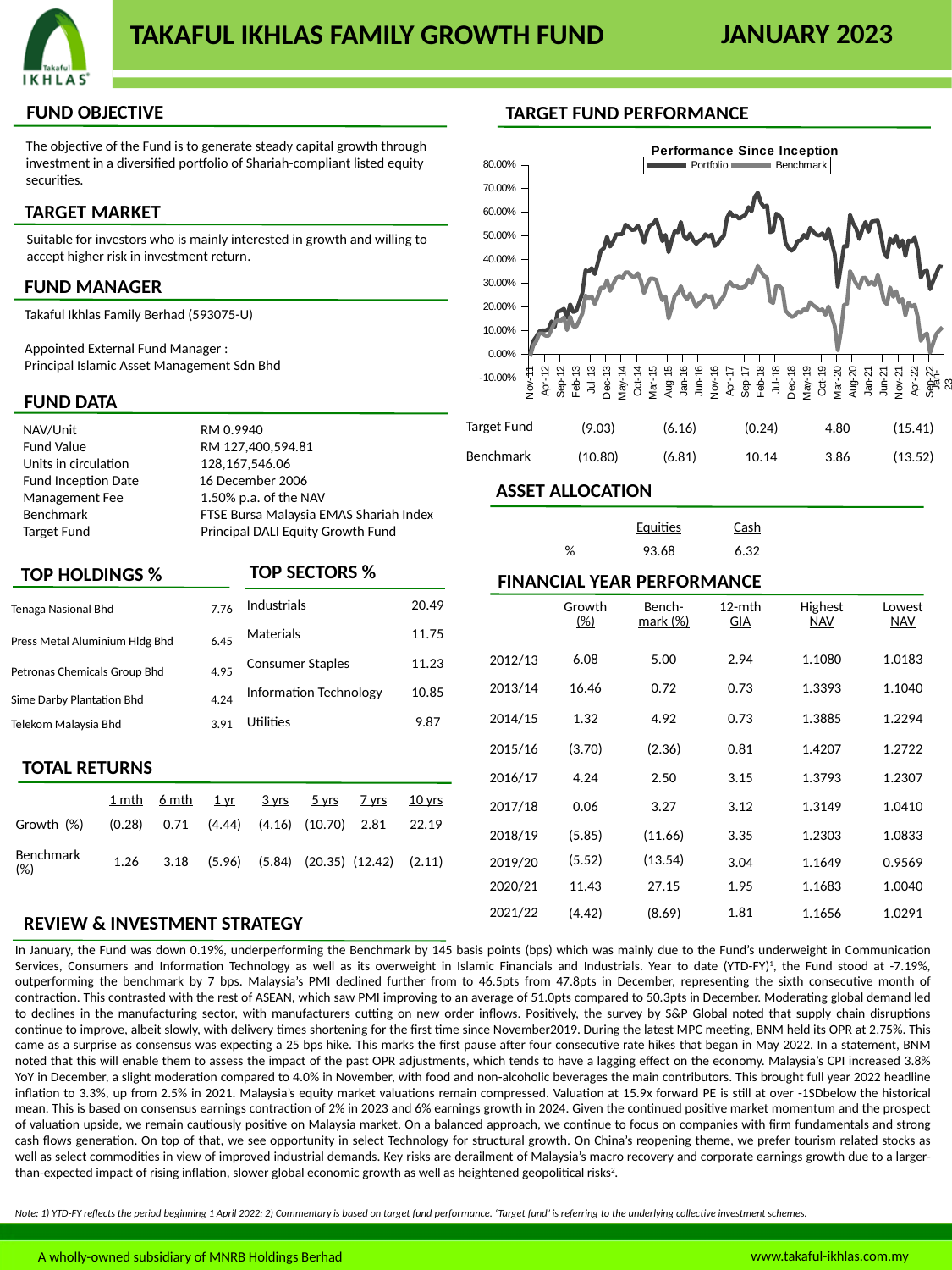
In the "Performance Since Inception" chart, which series reaches the higher peak value, Portfolio or Benchmark? Portfolio In the "Performance Since Inception" chart, is the Benchmark line's value around Mar-20 greater or less than 10.00%? less In the "Performance Since Inception" chart, is the Benchmark line's value at the end of the series (Jan-23) greater or less than 20.00%? less How many series does the legend of the "Performance Since Inception" chart list? 2 What are the two series named in the legend of the "Performance Since Inception" chart? Portfolio and Benchmark In the "Performance Since Inception" chart, is the Benchmark line's peak around Feb-18 greater or less than 30.00%? greater What is the highest value shown on the y axis of the "Performance Since Inception" chart? 80.00% In the "Performance Since Inception" chart, does the Portfolio line generally rise or fall from Nov-11 to Feb-18? rise What kind of chart is the "Performance Since Inception" chart? line chart In the "Performance Since Inception" chart, which series is higher at the end of the period, Portfolio or Benchmark? Portfolio